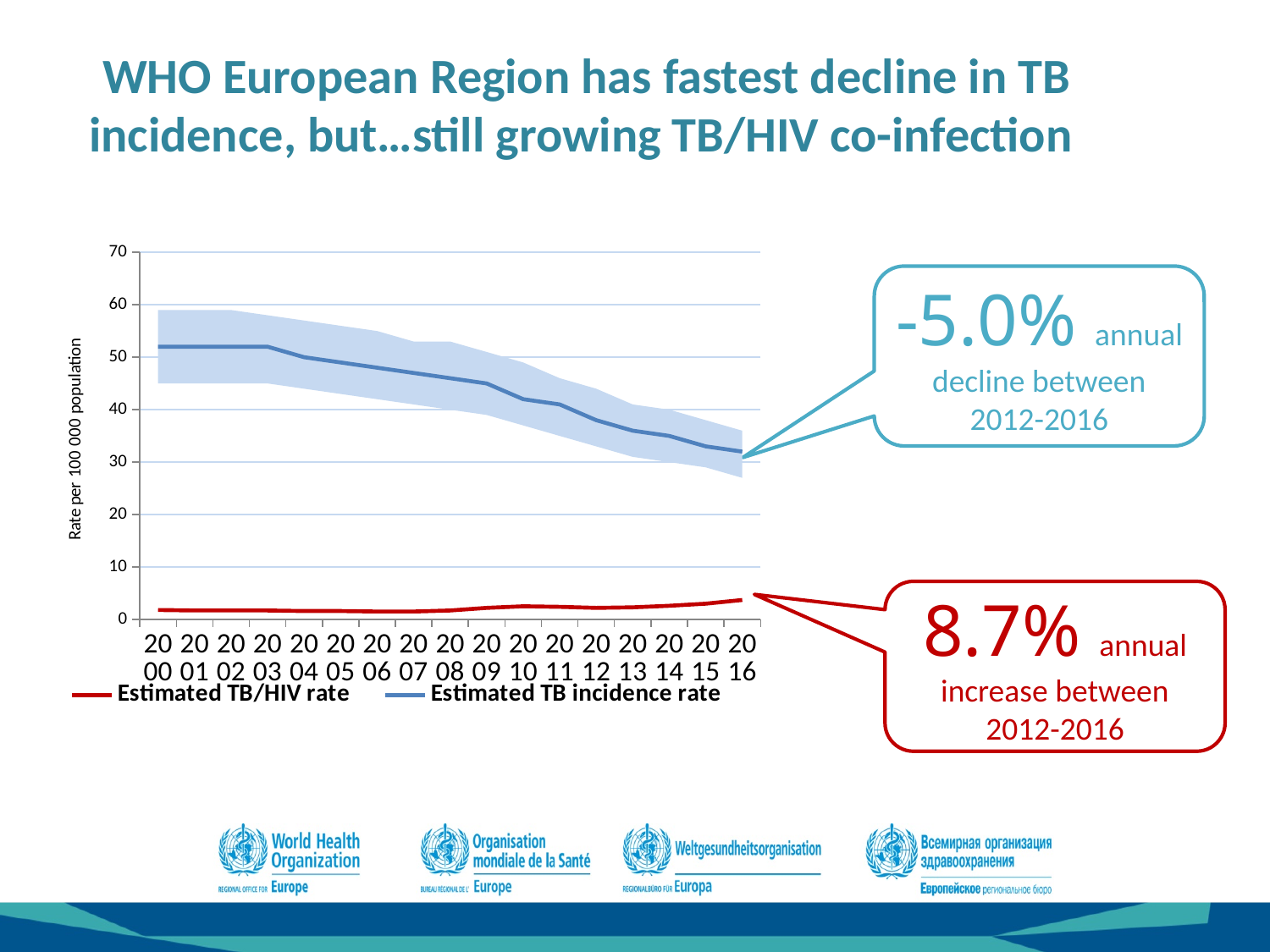
How many series does the chart legend list? 2 In 2016, which series has the larger value: Estimated TB/HIV rate or Estimated TB incidence rate? Estimated TB incidence rate According to the callout, what was the annual decline in TB incidence between 2012-2016? -5.0% Is the Estimated TB incidence rate in 2016 greater or less than 40? less What kind of chart is shown on the slide? Line chart What is the label on the y axis of the chart? Rate per 100 000 population How many years are plotted along the x axis of the chart? 17 Is the Estimated TB/HIV rate in 2016 greater or less than 10? less Does the Estimated TB incidence rate rise or fall from 2000 to 2016? Fall Is the Estimated TB incidence rate in 2000 greater or less than 50? greater In which year is the Estimated TB incidence rate lowest? 2016 Does the Estimated TB/HIV rate rise or fall from 2012 to 2016? Rise